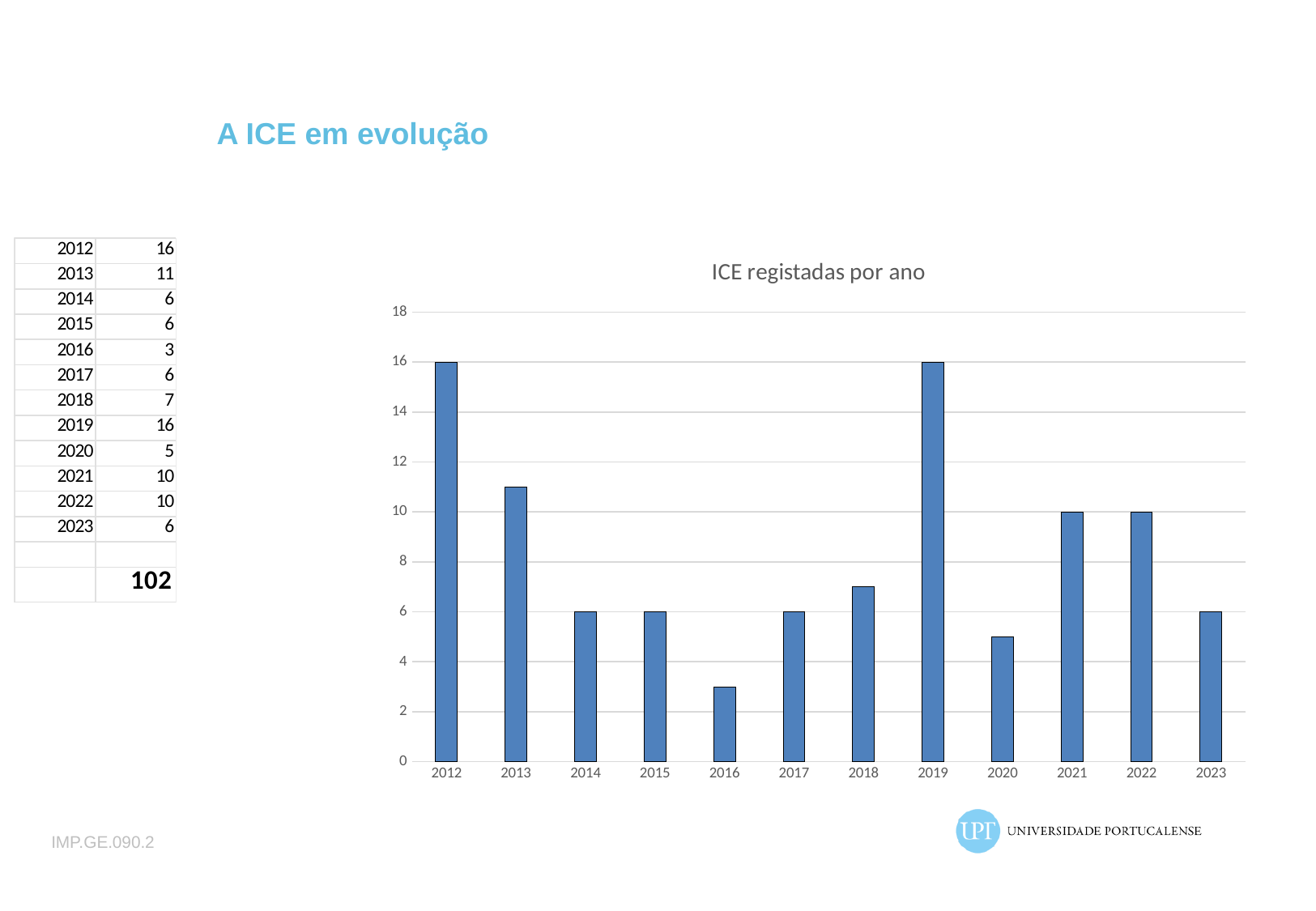
What is the value for 2012 in the chart? 16 What is the title of the chart? ICE registadas por ano What is the total of all the yearly values shown in the table on the slide? 102 Is the value for 2022 greater or less than 8? greater Which is larger, the value for 2019 or the value for 2021? 2019 What is the value for 2016 in the chart? 3 How many years are shown on the x axis of the chart? 12 Which year has the lowest value in the chart? 2016 What type of chart is shown on the slide? bar chart What is the value for 2020 in the chart? 5 What is the difference between the values for 2013 and 2014? 5 What is the value for 2018 in the chart? 7